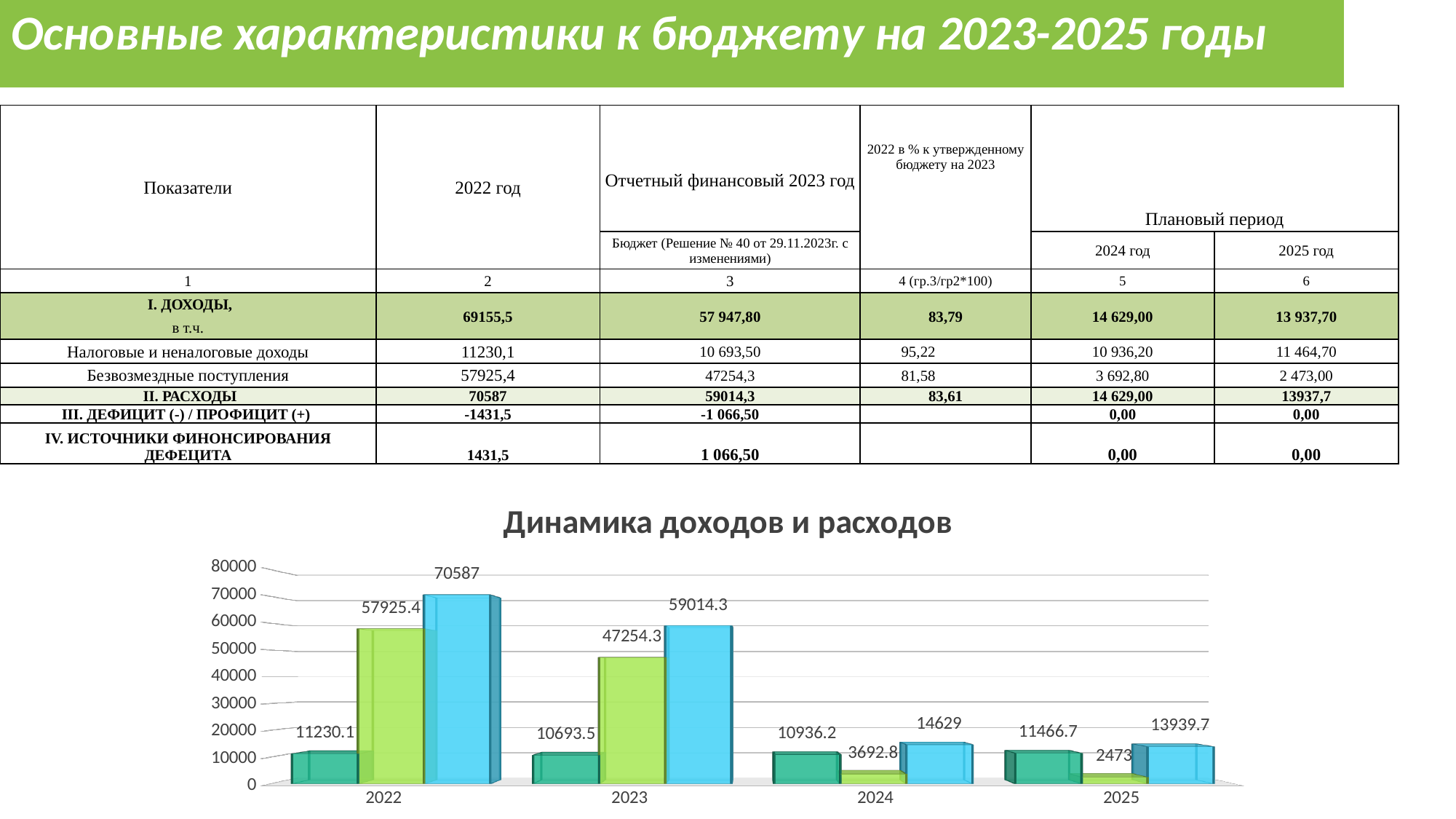
Which is larger in the chart: the blue bar for 2024 or the blue bar for 2025? the blue bar for 2024 What is the difference between the blue bar (70587) and the light green bar (57925.4) for 2022? 12661.6 What is the value of the dark green bar for 2025 in the chart? 11466.7 What is the value of the tallest (blue) bar for 2022 in the chart? 70587 What kind of chart is shown under the title "Динамика доходов и расходов"? bar chart In which year is the blue bar the highest in the chart? 2022 In which year is the light green bar the lowest in the chart? 2025 What is the value of the light green bar for 2023 in the chart? 47254.3 Is the value of the light green bar for 2023 greater or less than 40000? greater Do the blue bars rise or fall from 2022 to 2025 in the chart? fall How many year categories are shown on the x axis of the chart? 4 What is the title of the chart on the slide? Динамика доходов и расходов